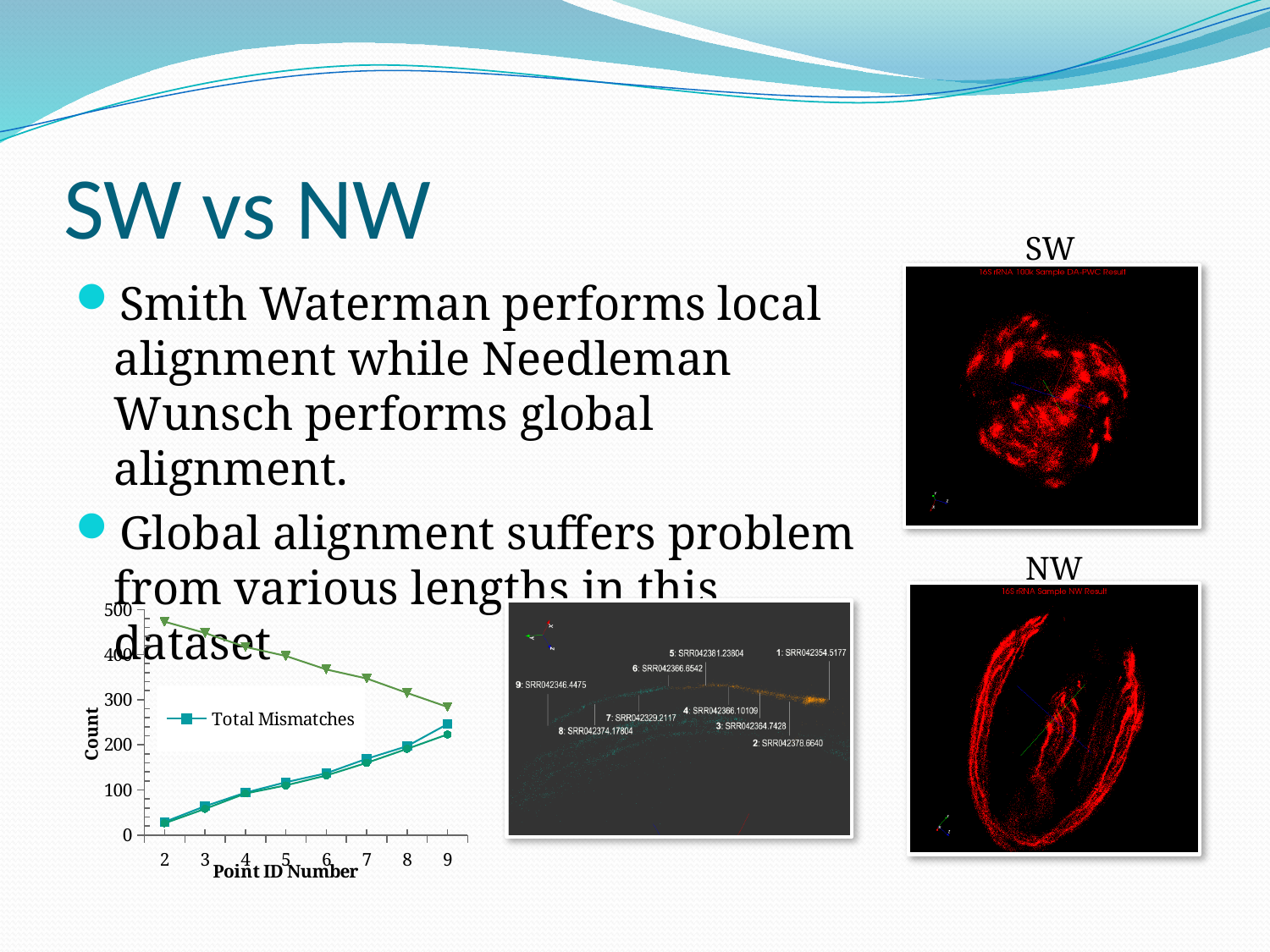
In the bottom-left line chart, what is the title of the x axis? Point ID Number What kind of chart is shown at the bottom left of the slide? line chart In the bottom-left line chart, is the value of the triangle-marker series at Point ID Number 2 greater or less than 400? greater In the bottom-left line chart, is the Total Mismatches value at Point ID Number 9 greater or less than 200? greater In the bottom-left line chart, which is larger at Point ID Number 2: the Total Mismatches value or the value of the triangle-marker series? the triangle-marker series In the bottom-left line chart, is the Total Mismatches value at Point ID Number 2 greater or less than 100? less In the bottom-left line chart, does the Total Mismatches series rise or fall as the Point ID Number increases? rise In the bottom-left line chart, how many Point ID Number values are shown along the x axis? 8 In the bottom-left line chart, what is the title of the y axis? Count In the bottom-left line chart, does the series with triangle markers rise or fall as the Point ID Number increases? fall